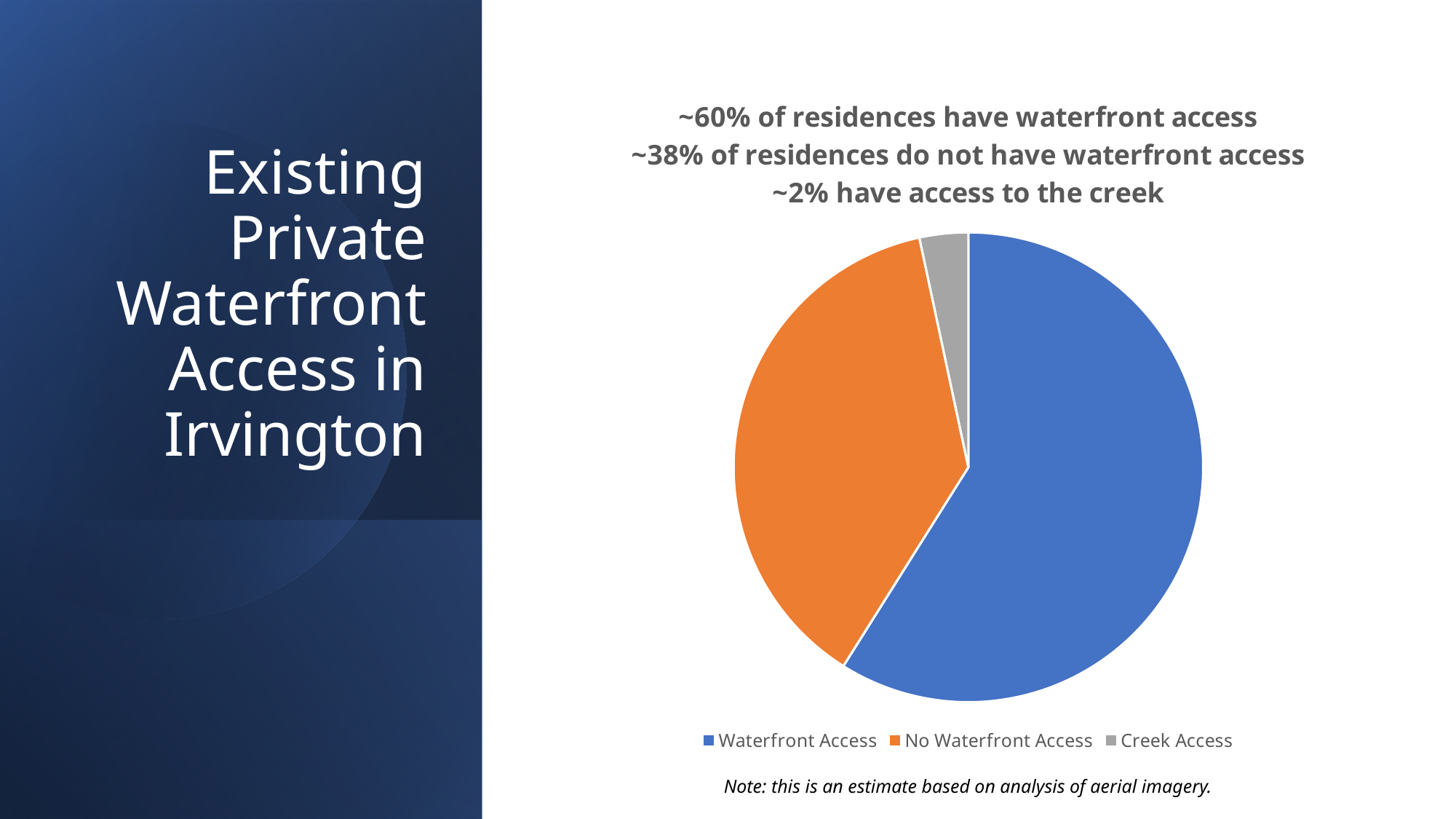
How many entries does the legend of the pie chart list? 3 Which category has the largest slice of the pie chart? Waterfront Access What are the three legend entries of the pie chart? Waterfront Access, No Waterfront Access, Creek Access Which slice is larger, No Waterfront Access or Creek Access? No Waterfront Access What colour is the Waterfront Access slice in the pie chart? Blue What kind of chart is shown on the slide? Pie chart Which category has the smallest slice of the pie chart? Creek Access How many slices does the pie chart have? 3 Which slice is smaller, Creek Access or Waterfront Access? Creek Access Which slice is larger, Waterfront Access or No Waterfront Access? Waterfront Access